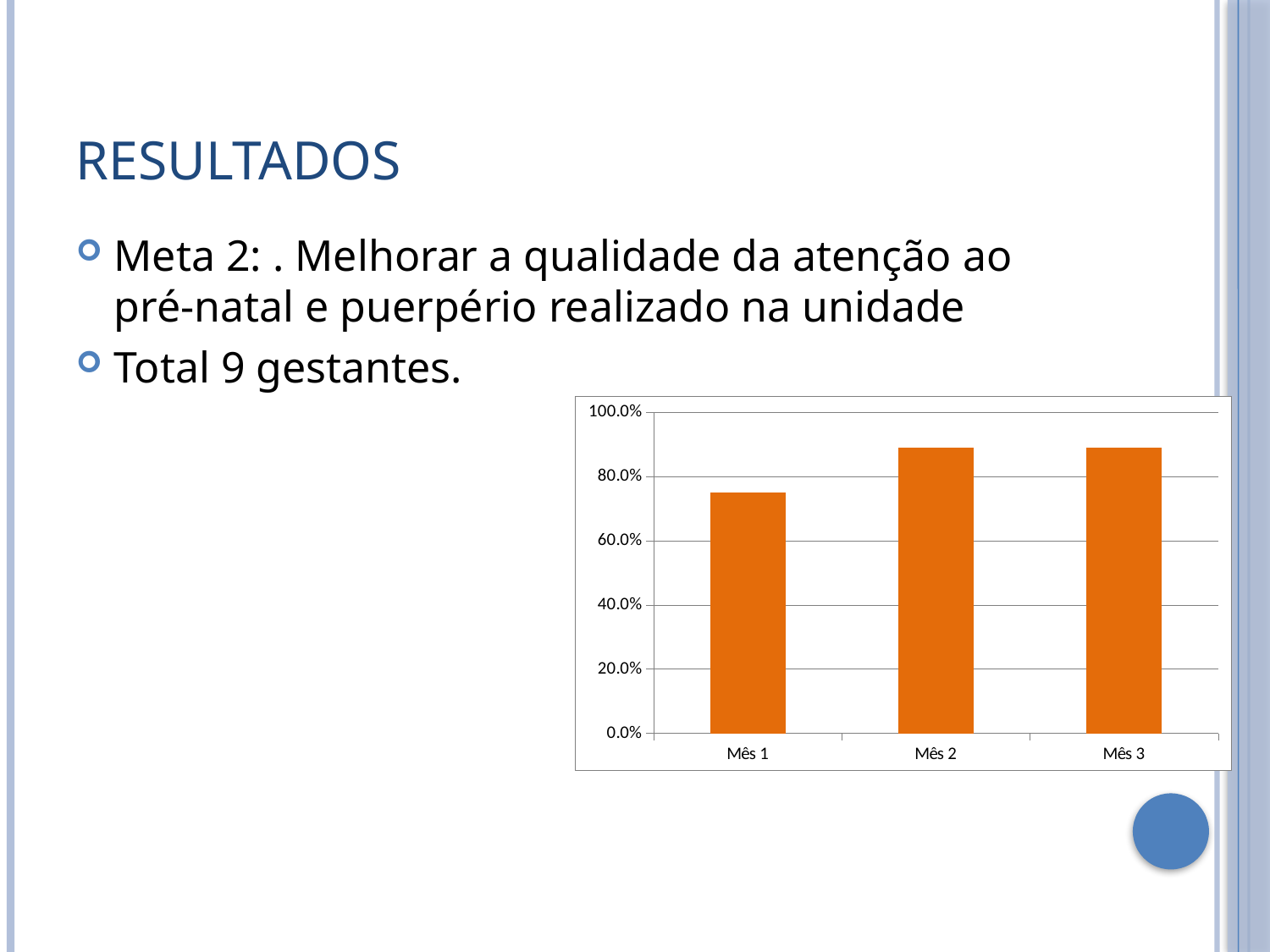
Which is larger, the value for Mês 1 or the value for Mês 2? Mês 2 Is the value for Mês 1 greater or less than 60.0%? greater What kind of chart is shown on the slide? bar chart Does the value rise or fall from Mês 1 to Mês 2? rise What colour are the bars in the chart? orange Which category has the lowest bar in the chart? Mês 1 Is the value for Mês 3 greater or less than 80.0%? greater Is the value for Mês 1 greater or less than 80.0%? less How many categories are plotted on the x axis of the chart? 3 Which is larger, the value for Mês 1 or the value for Mês 3? Mês 3